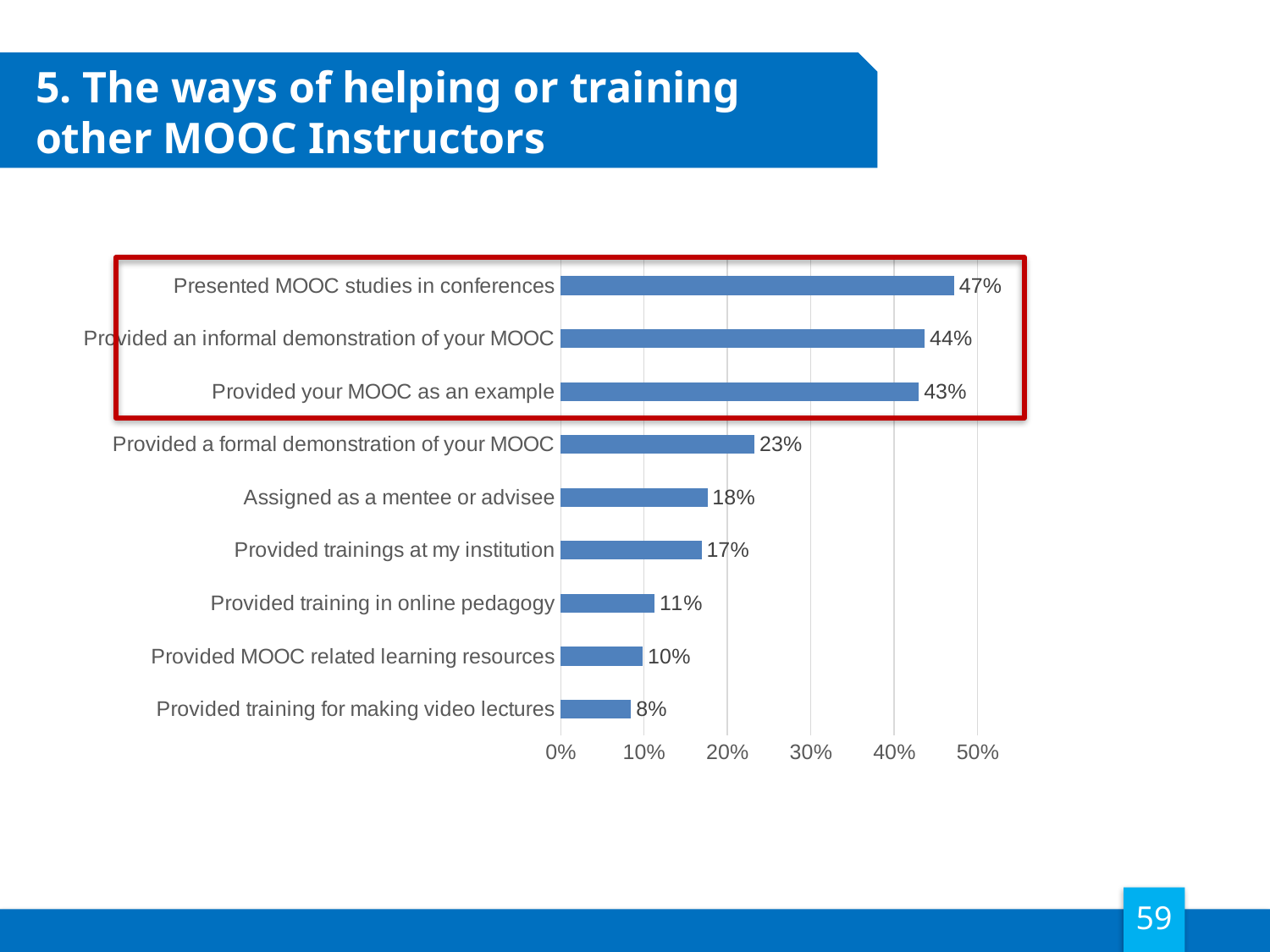
What is the difference between "Provided training in online pedagogy" and "Provided MOOC related learning resources"? 1% Is the value for "Provided an informal demonstration of your MOOC" greater or less than 40%? greater What percentage is shown for "Provided training for making video lectures"? 8% What is the difference between "Presented MOOC studies in conferences" and "Provided your MOOC as an example"? 4% What percentage is shown for "Presented MOOC studies in conferences"? 47% What is the value for "Provided a formal demonstration of your MOOC"? 23% Which category has the highest value? Presented MOOC studies in conferences Which category has the lowest value? Provided training for making video lectures What kind of chart is shown on the slide? Bar chart How many categories are shown in the chart? 9 How many categories are enclosed by the red box on the chart? 3 Which is larger: "Assigned as a mentee or advisee" or "Provided trainings at my institution"? Assigned as a mentee or advisee